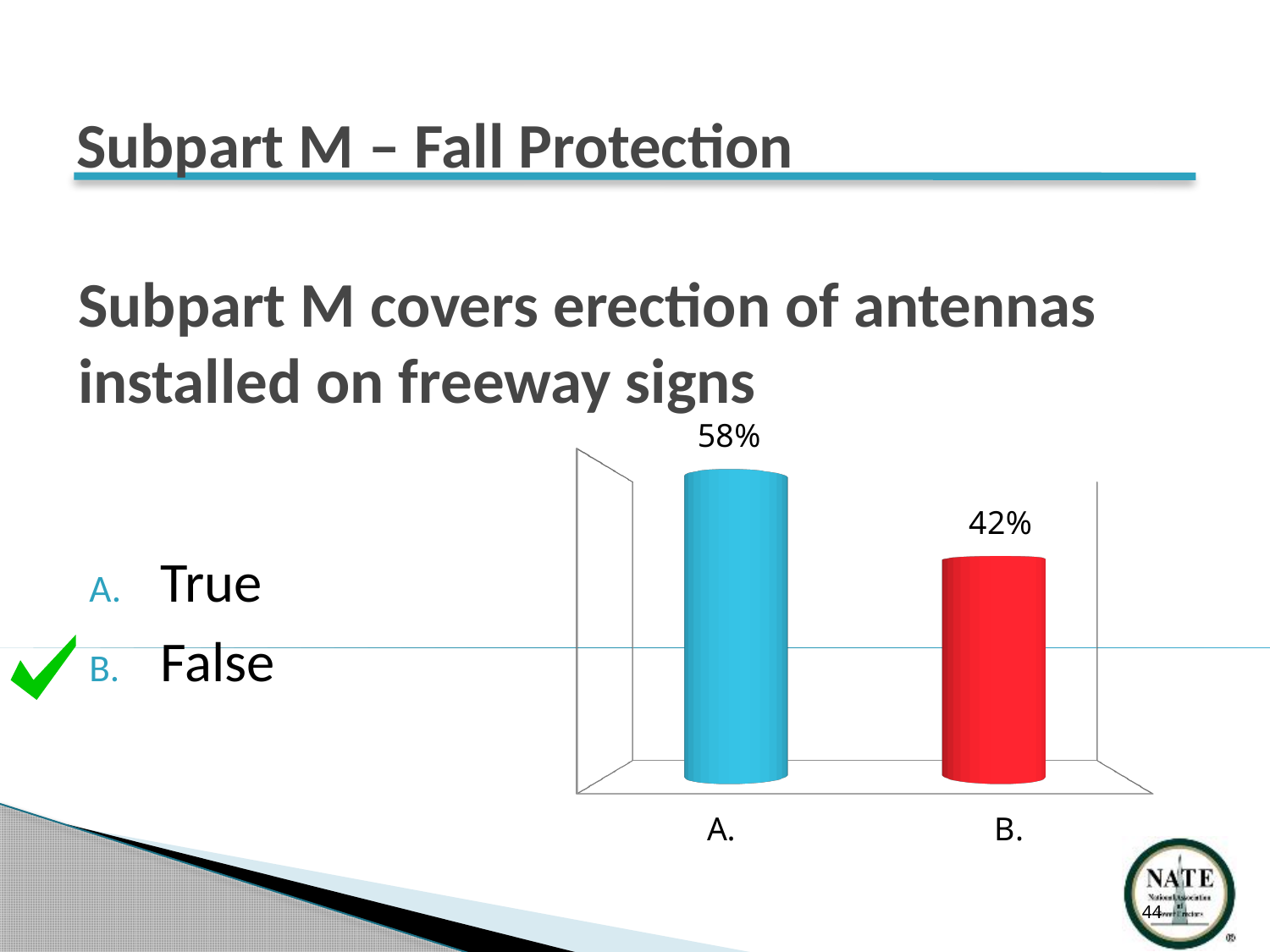
Which category has the highest value in the chart? A. What colour is the bar for category A. in the chart? blue What is the difference between the values for A. and B. in the chart? 16% Do the values rise or fall from A. to B. along the x axis? fall What kind of chart is shown on the slide? bar chart What is the value shown for category A. in the chart? 58% What colour is the bar for category B. in the chart? red How many categories are plotted in the chart? 2 What is the value shown for category B. in the chart? 42% Which category has the lowest value in the chart? B. What is the total of the values for A. and B. in the chart? 100% Which is larger in the chart, the value for A. or the value for B.? A.